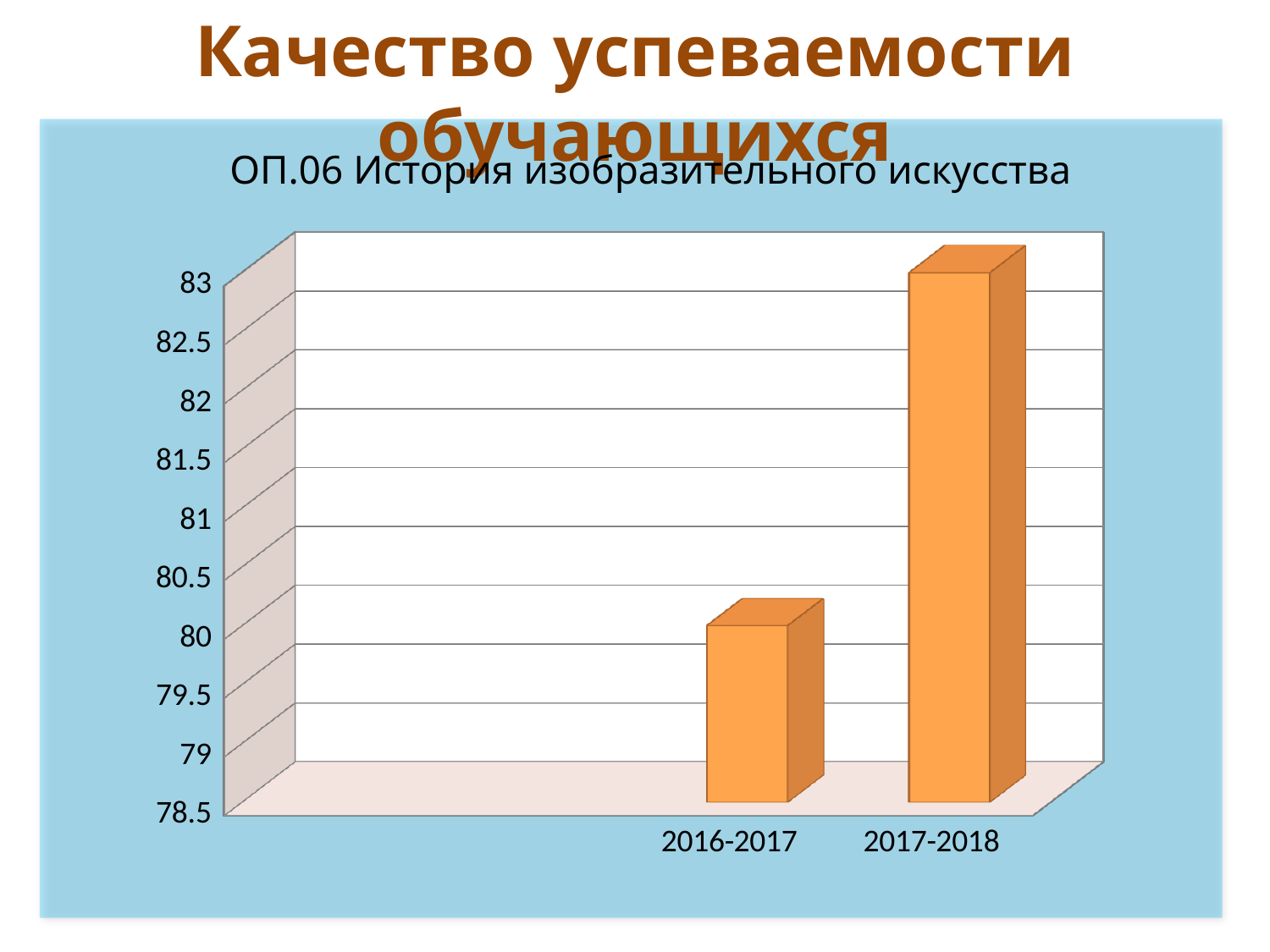
Which is larger, the value for 2016-2017 or the value for 2017-2018? 2017-2018 What kind of chart is shown on the slide? bar chart What is the title of the chart? ОП.06 История изобразительного искусства Is the value for 2016-2017 greater or less than 79? greater Which academic year has the highest value in the chart? 2017-2018 What is the lowest value shown on the vertical axis of the chart? 78.5 How many categories are shown on the x axis of the chart? 2 Do the values rise or fall from 2016-2017 to 2017-2018? rise Is the value for 2016-2017 greater or less than 81? less Is the value for 2017-2018 greater or less than 82? greater Which academic year has the lowest value in the chart? 2016-2017